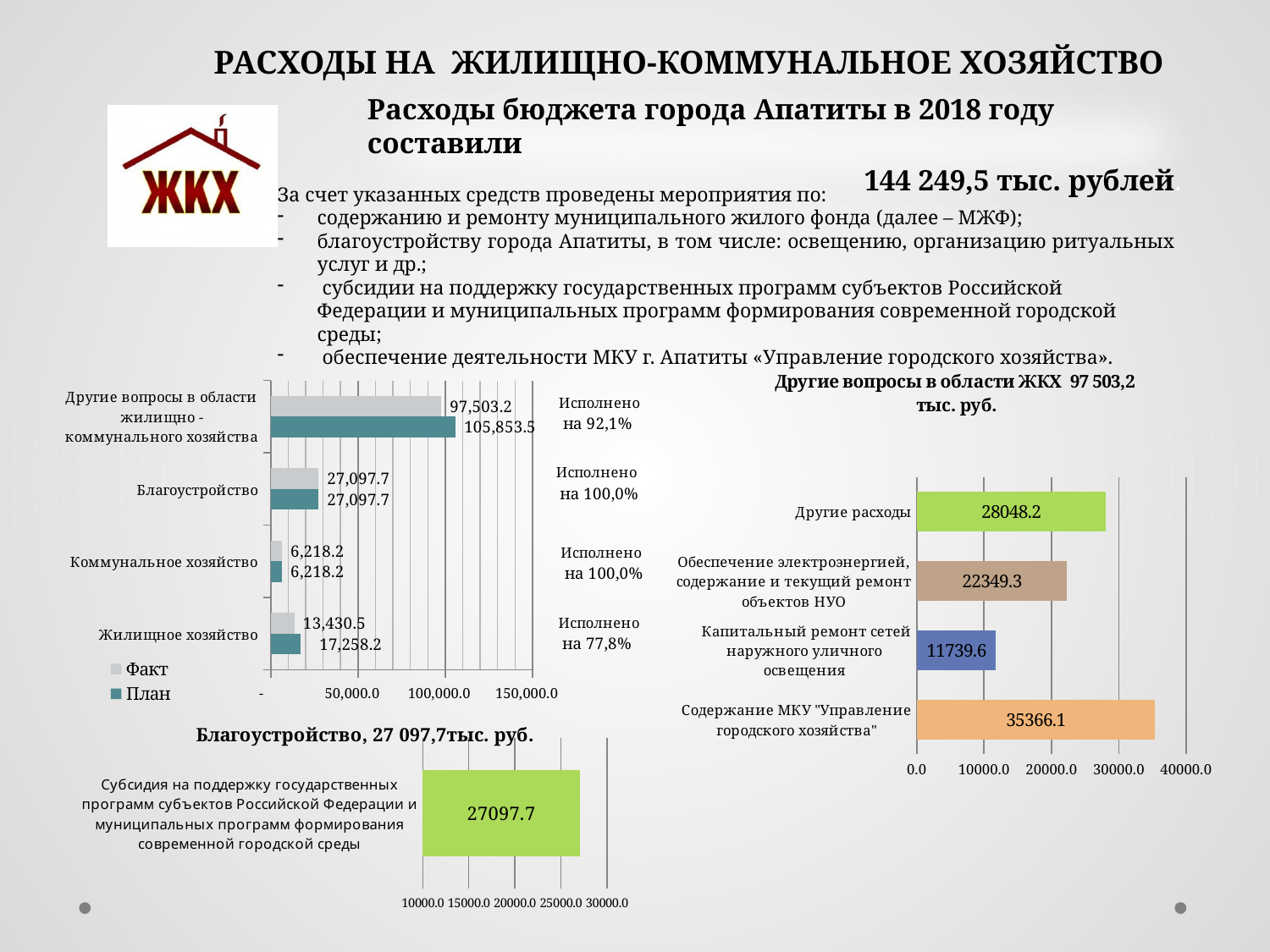
What kind of chart is the chart titled 'Благоустройство, 27 097,7тыс. руб.'? bar chart On the left chart with Факт and План series, how many series does the legend list? 2 On the left chart with Факт and План series, what is the difference between the План and Факт values for Другие вопросы в области жилищно-коммунального хозяйства? 8,350.3 On the chart titled 'Другие вопросы в области ЖКХ 97 503,2 тыс. руб.', which category has the highest value? Содержание МКУ "Управление городского хозяйства" On the left chart with Факт and План series, what is the План value for Жилищное хозяйство? 17,258.2 On the left chart with Факт and План series, what is the Факт value for Другие вопросы в области жилищно-коммунального хозяйства? 97,503.2 On the chart titled 'Благоустройство, 27 097,7тыс. руб.', what is the value of the single bar? 27097.7 On the left chart with Факт and План series, which category has the lowest Факт value? Коммунальное хозяйство On the chart titled 'Другие вопросы в области ЖКХ 97 503,2 тыс. руб.', what is the value for Капитальный ремонт сетей наружного уличного освещения? 11739.6 On the left chart with Факт and План series, how many categories are shown? 4 On the chart titled 'Другие вопросы в области ЖКХ 97 503,2 тыс. руб.', is the value for Другие расходы greater or less than 30000.0? less On the chart titled 'Другие вопросы в области ЖКХ 97 503,2 тыс. руб.', what is the difference between Другие расходы and Обеспечение электроэнергией, содержание и текущий ремонт объектов НУО? 5698.9